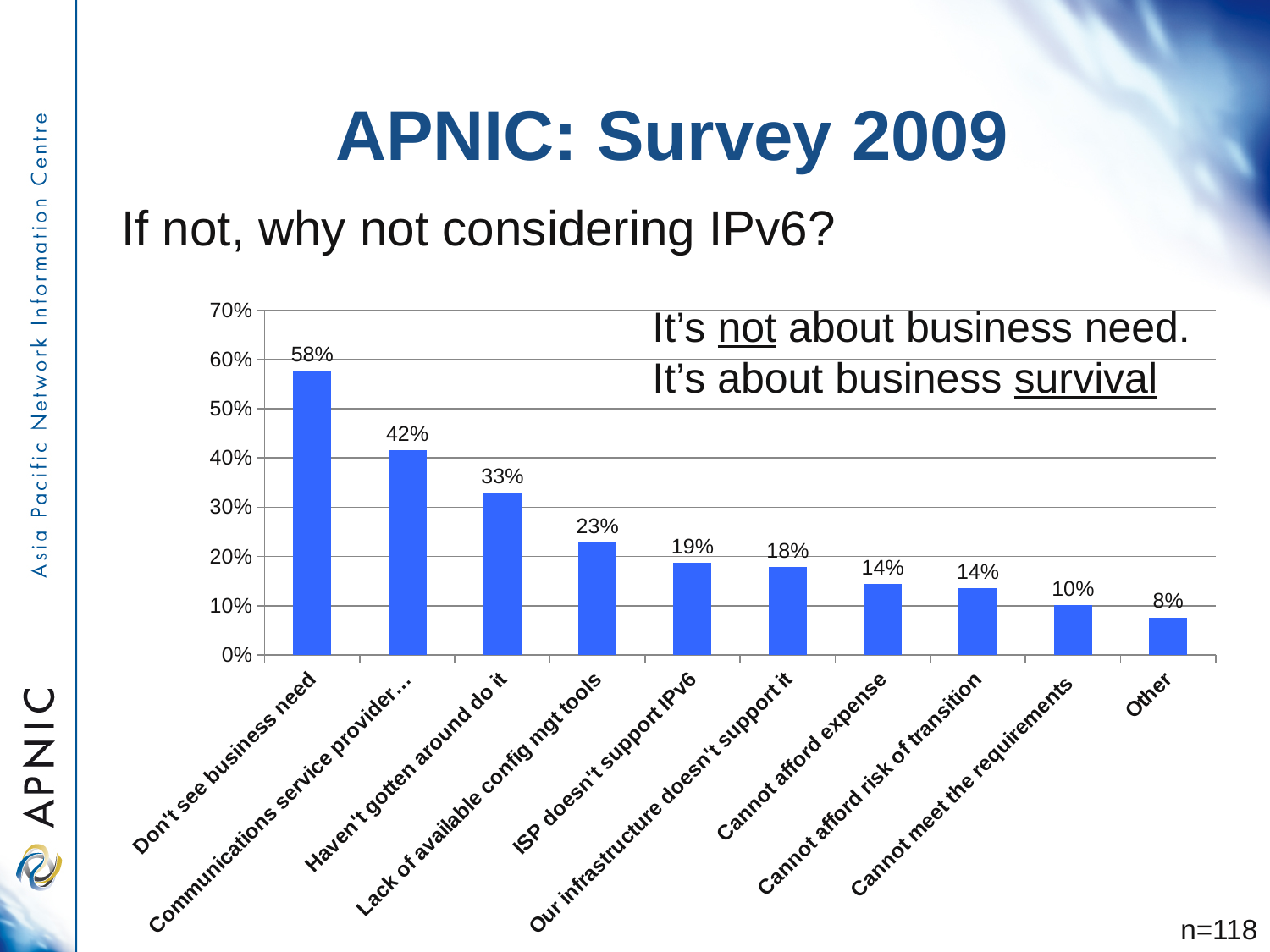
Do the values rise or fall from left to right along the x axis? Fall What percentage is shown for "Don't see business need"? 58% What percentage is shown for "ISP doesn't support IPv6"? 19% What is the value for "Lack of available config mgt tools"? 23% What is the difference between "Don't see business need" and "Haven't gotten around do it"? 25% Which category has the lowest value? Other Which category has the highest value? Don't see business need What kind of chart is shown on the slide? Bar chart Which is larger, "Cannot afford expense" or "Cannot meet the requirements"? Cannot afford expense How many categories are plotted in the chart? 10 What is the value for "Other"? 8% Is the value for "Our infrastructure doesn't support it" greater or less than 20%? less